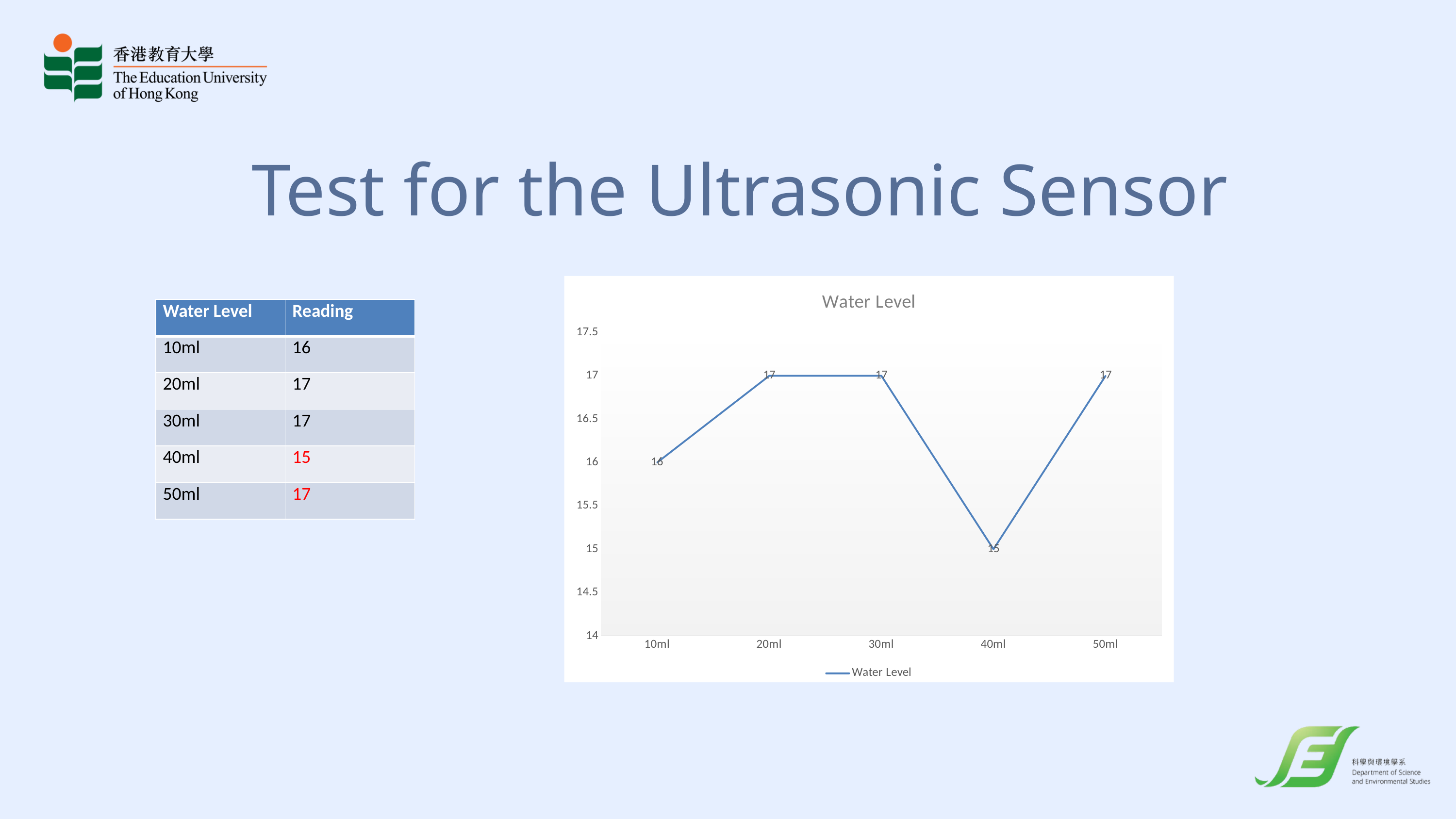
What is the difference between the readings at 30ml and 40ml? 2 How many categories are plotted on the x axis? 5 What is the difference between the readings at 20ml and 10ml? 1 What is the Water Level reading at 50ml? 17 Is the reading at 40ml greater or less than 16? less What is the Water Level reading at 40ml? 15 Which is larger, the reading at 10ml or the reading at 40ml? 10ml How many series does the legend list? 1 What is the title of the chart? Water Level What kind of chart is shown? line chart Which category has the lowest Water Level reading? 40ml What is the Water Level reading at 10ml? 16